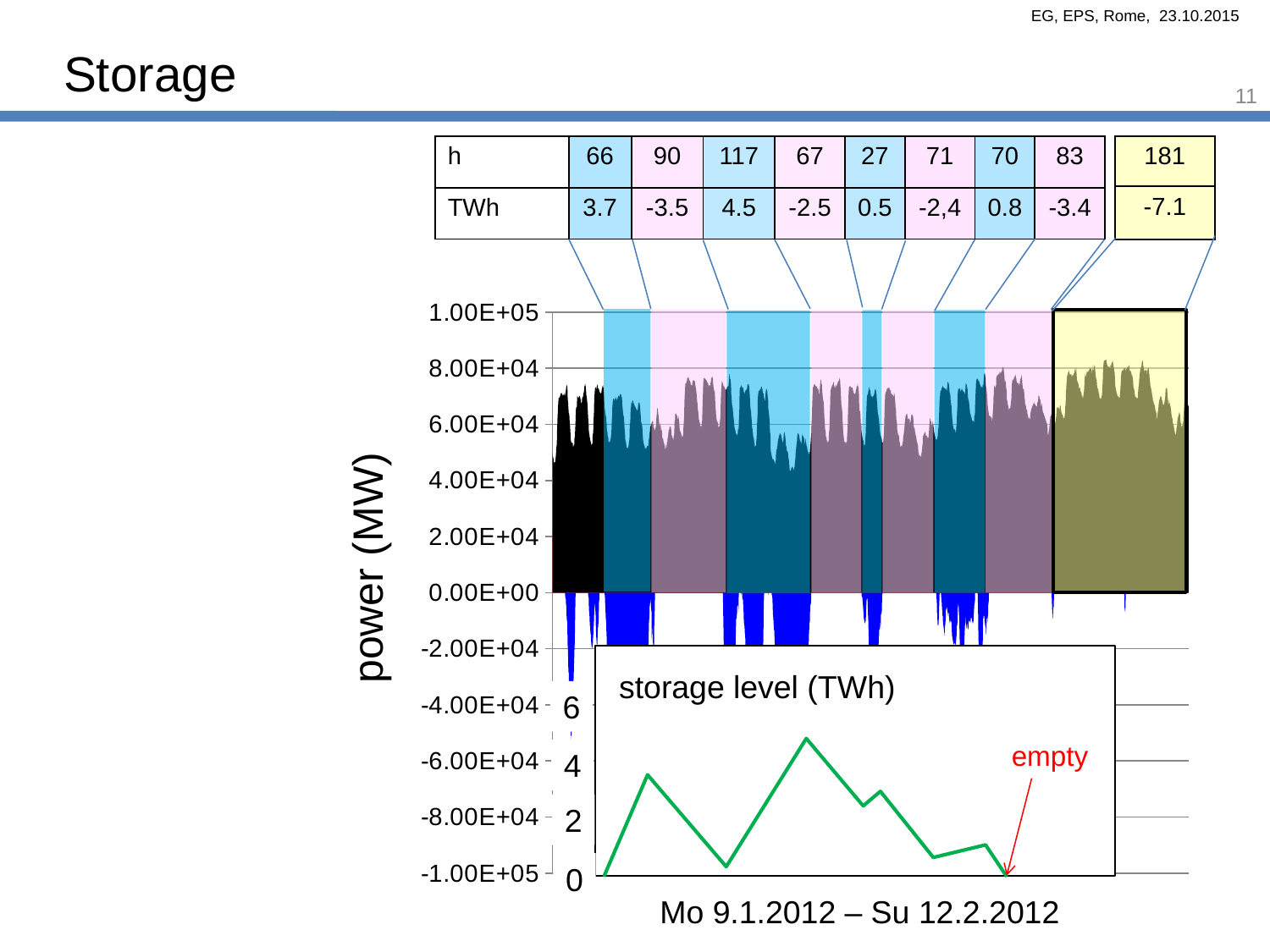
In the inset 'storage level (TWh)' chart, is the highest storage level greater or less than 4? greater In the table above the main chart, what is the TWh value for the final yellow-highlighted period? -7.1 In the table above the main chart, which period has the lowest TWh value? the 181 h period (-7.1) How many numeric columns does the table above the main chart contain? 9 In the table above the main chart, what is the TWh value for the period lasting 117 h? 4.5 What kind of chart is the inset chart titled 'storage level (TWh)'? line chart In the table above the main chart, what is the TWh value for the period lasting 90 h? -3.5 In the table above the main chart, how many hours does the final yellow-highlighted period last? 181 In the table above the main chart, which has the larger TWh value: the 66 h period or the 27 h period? the 66 h period What is the y-axis label of the main chart? power (MW) In the table above the main chart, which period has the highest TWh value? the 117 h period (4.5) In the table above the main chart, what is the difference between the TWh values of the 117 h period and the 66 h period? 0.8